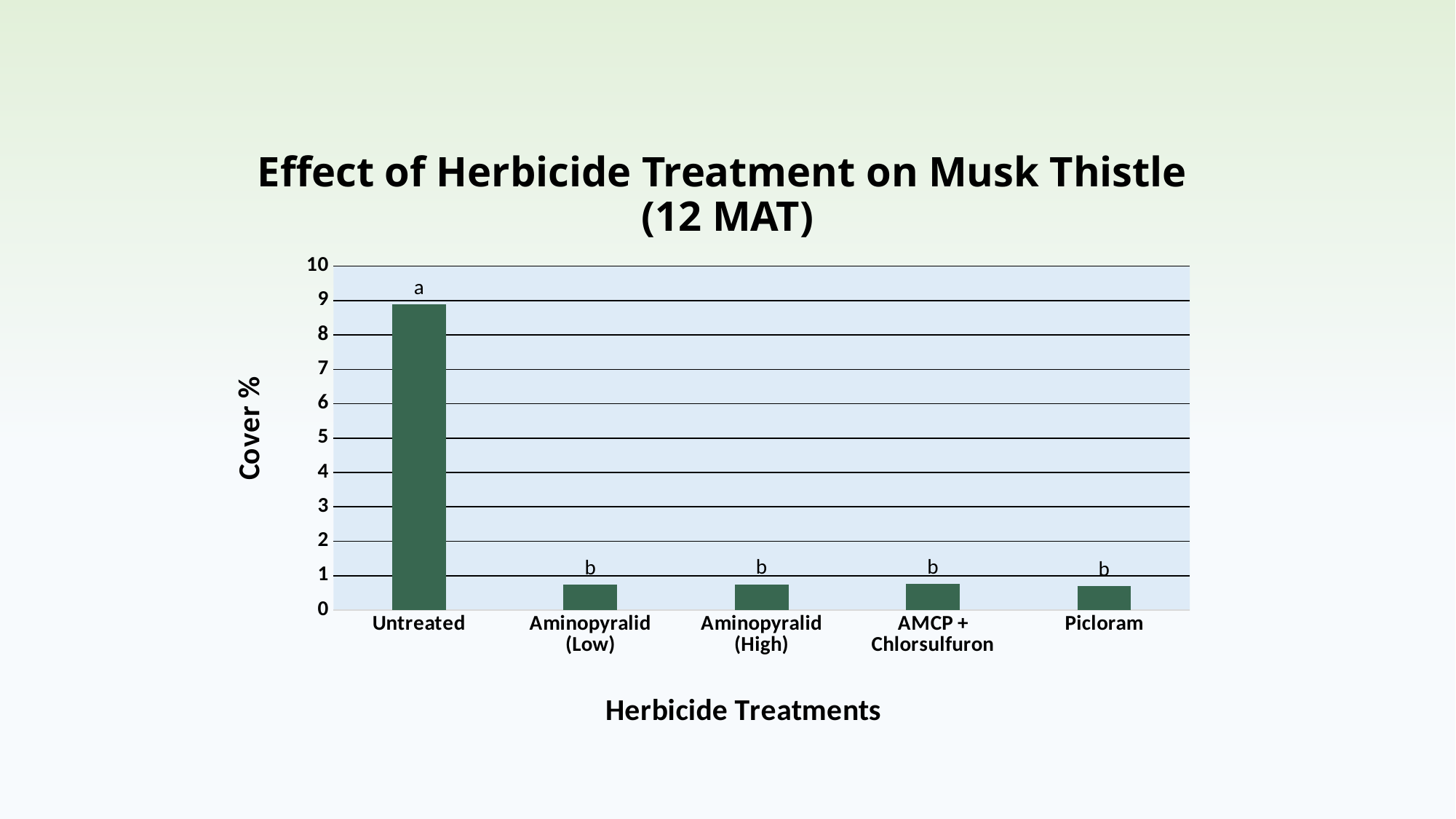
What is the title of the chart? Effect of Herbicide Treatment on Musk Thistle (12 MAT) Is the Cover % for Untreated greater or less than 8? greater How many herbicide treatment categories are shown on the x axis? 5 Is the Cover % for Aminopyralid (Low) greater or less than 2? less Which treatment has the highest Cover %? Untreated What letter is printed above the Untreated bar? a What is the maximum value shown on the y axis? 10 What kind of chart is shown on the slide? bar chart Which has a larger Cover %, Untreated or Aminopyralid (High)? Untreated What is the label on the y axis? Cover % Is the Cover % for AMCP + Chlorsulfuron greater or less than 1? less